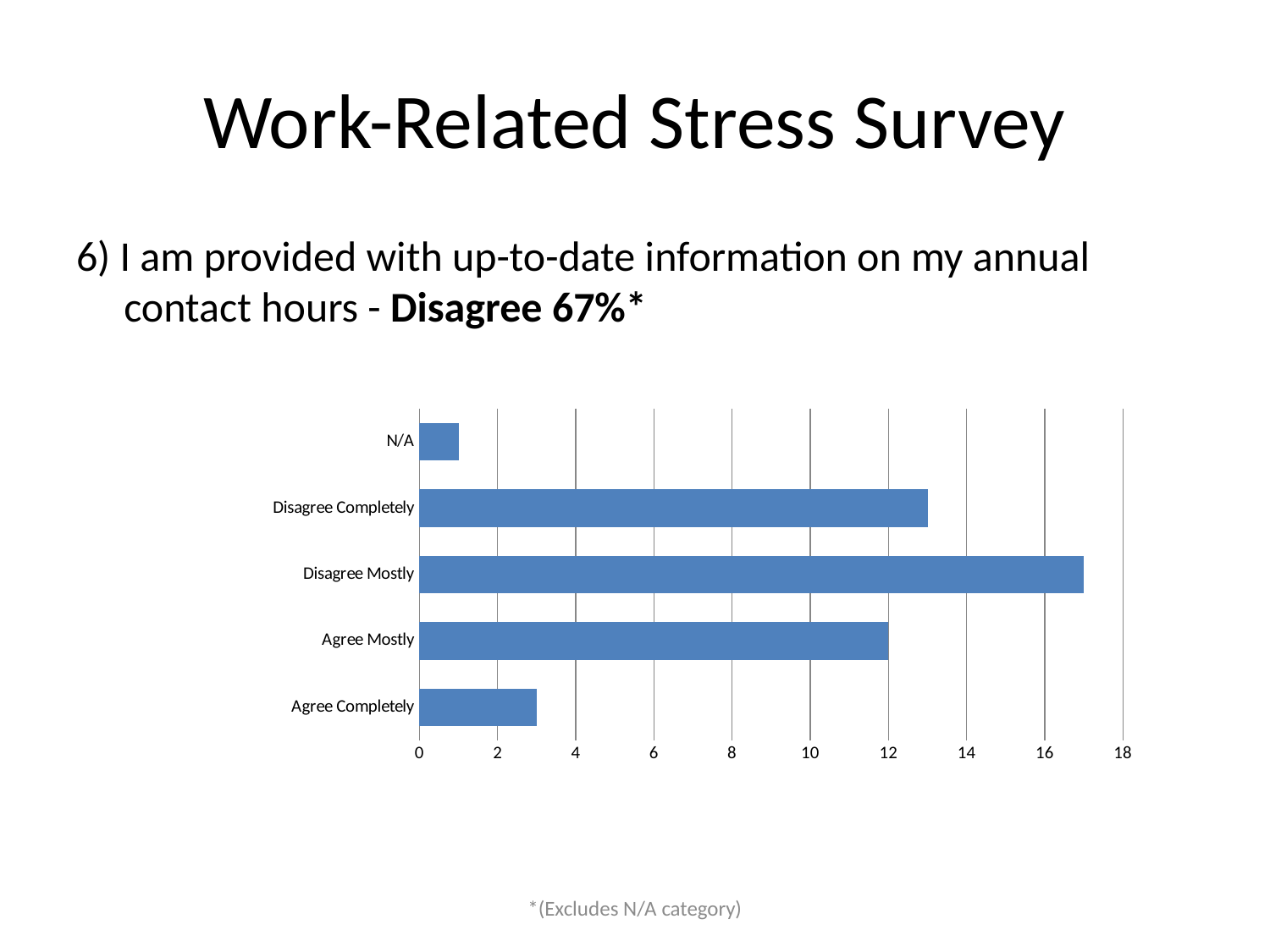
Is the value for Disagree Mostly greater or less than 16? greater How many categories are shown on the chart? 5 What is the highest value shown on the horizontal axis of the chart? 18 Is the value for N/A greater or less than 2? less Which category has the lowest value? N/A Is the value for Agree Completely greater or less than 4? less Which is larger, the value for Disagree Mostly or the value for Agree Completely? Disagree Mostly What is the value for Agree Mostly? 12 Which is larger, the value for Agree Mostly or the value for N/A? Agree Mostly Which category has the highest value? Disagree Mostly What kind of chart is shown on the slide? bar chart